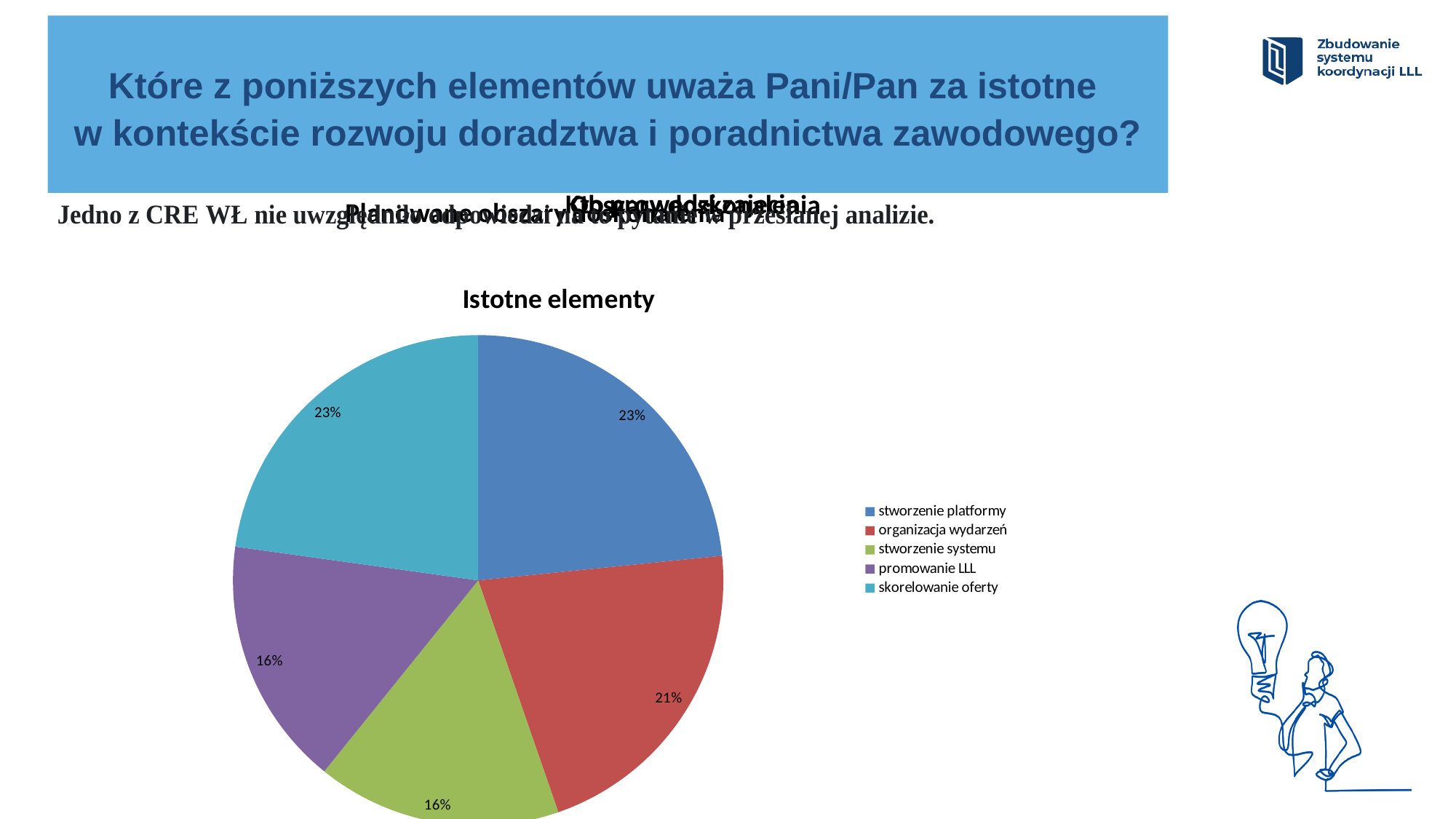
Which is larger, the share for 'stworzenie platformy' or for 'organizacja wydarzeń'? stworzenie platformy Which colour represents 'promowanie LLL' in the pie chart? purple What is the title of the chart? Istotne elementy How many entries does the legend list? 5 What kind of chart is shown on the slide? pie chart How many slices does the pie chart have? 5 What share of the pie does 'stworzenie platformy' have? 23% What is the difference in percentage points between the shares for 'organizacja wydarzeń' and 'stworzenie systemu'? 5 What share of the pie does 'promowanie LLL' have? 16% What share of the pie does 'skorelowanie oferty' have? 23% What share of the pie does 'stworzenie systemu' have? 16% What share of the pie does 'organizacja wydarzeń' have? 21%